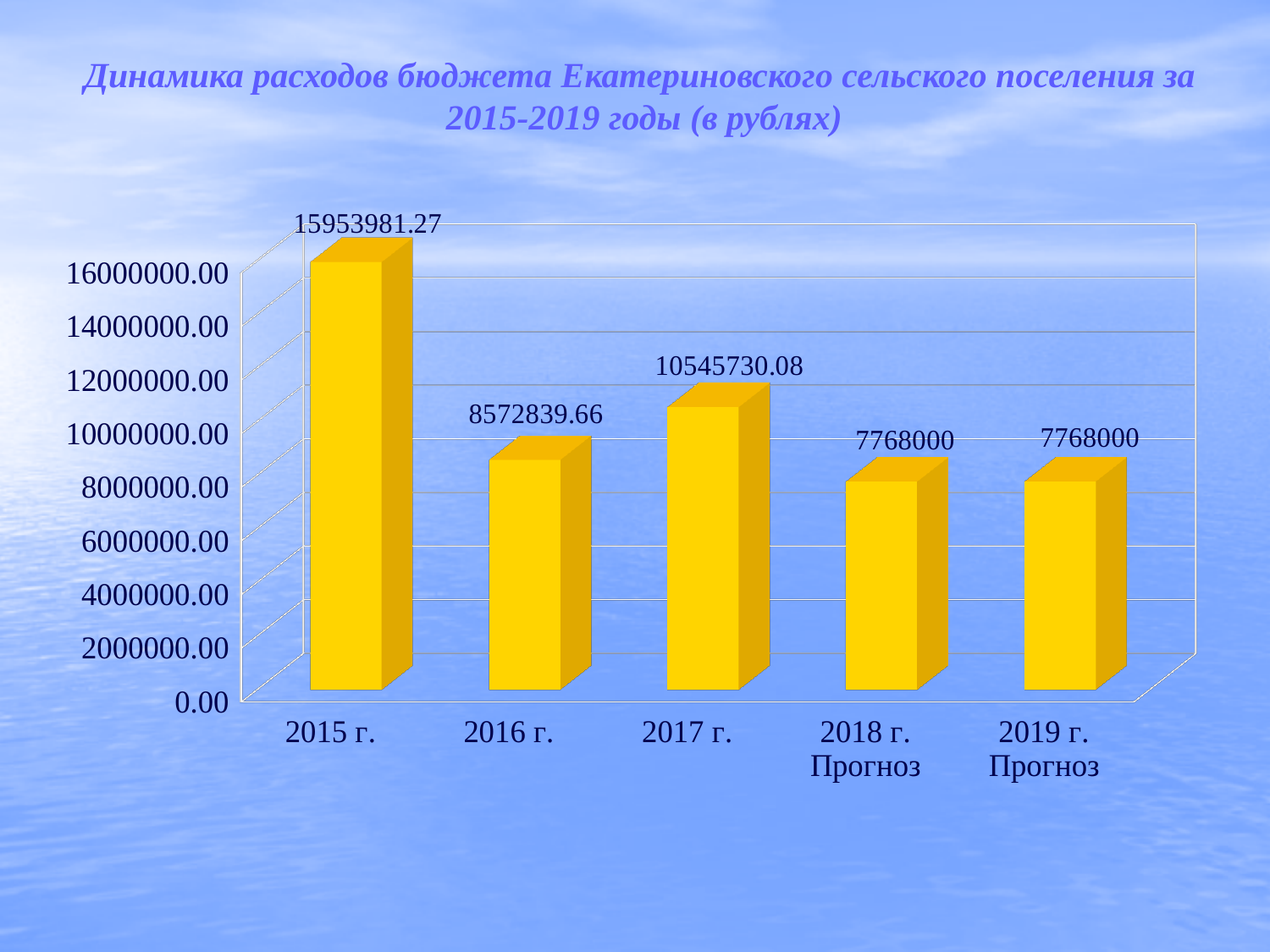
What is the value for 2016 г.? 8572839.66 Which year has the highest value? 2015 г. What is the value for 2018 г. Прогноз? 7768000 What is the value for 2015 г.? 15953981.27 Which is larger, the value for 2016 г. or the value for 2017 г.? 2017 г. What is the difference between the values for 2017 г. and 2016 г.? 1972890.42 How many categories are shown on the x axis? 5 What kind of chart is shown on the slide? bar chart What is the value for 2017 г.? 10545730.08 What is the difference between the values for 2015 г. and 2016 г.? 7381141.61 Does the value rise or fall from 2015 г. to 2016 г.? fall Is the value for 2016 г. greater or less than 10000000.00? less